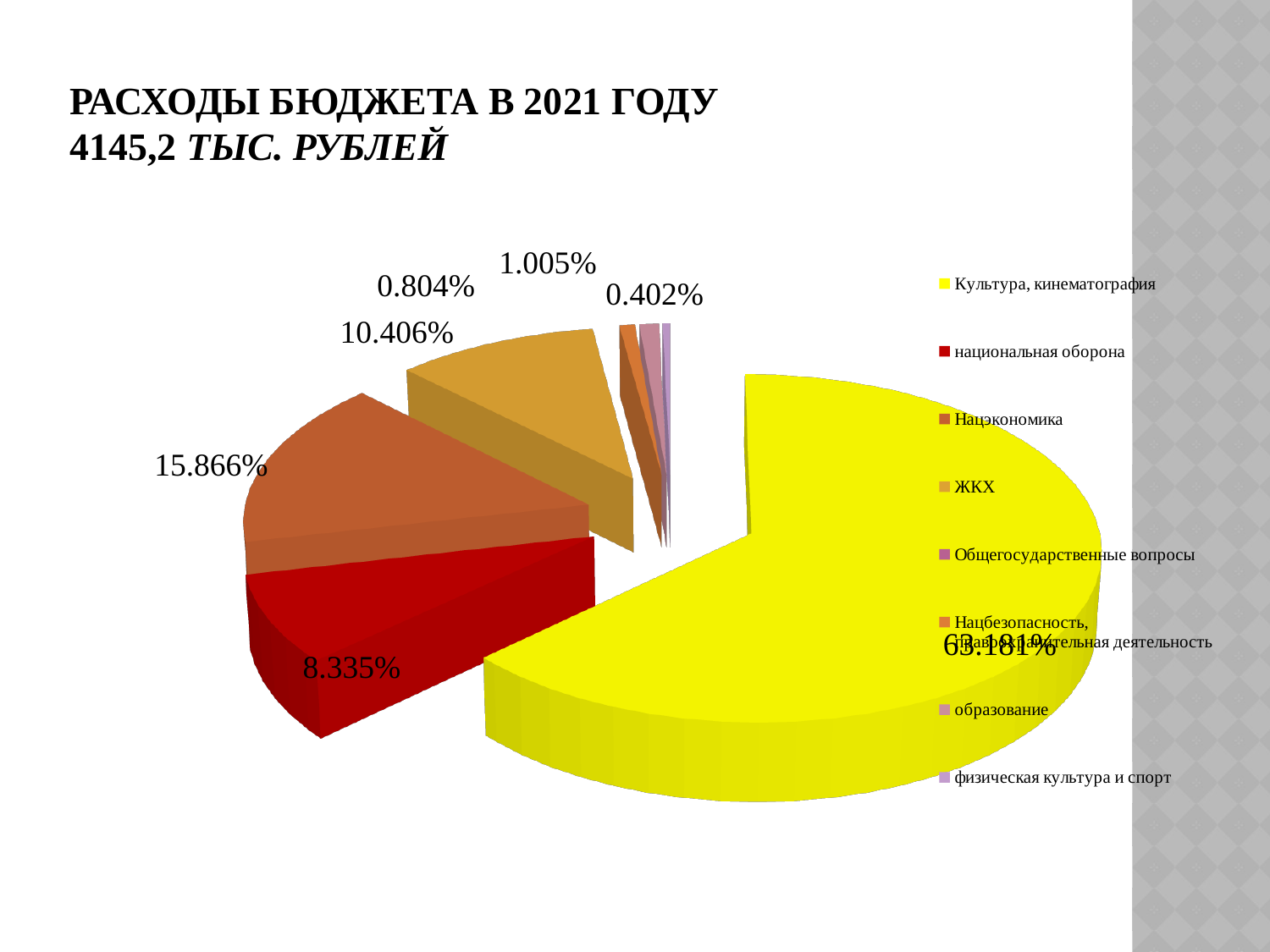
Which category has the largest share of the pie? Культура, кинематография What is the difference in percentage points between Культура, кинематография and национальная оборона? 54.846% What is the smallest percentage label shown on the pie chart? 0.402% What is the difference in percentage points between Нацэкономика and ЖКХ? 5.460% What percentage is shown for национальная оборона? 8.335% What type of chart is shown on the slide? pie chart What percentage is shown for Культура, кинематография? 63.181% How many entries does the legend list? 8 Which has the larger share, Нацэкономика or ЖКХ? Нацэкономика What percentage is shown for ЖКХ? 10.406% What is the title of the slide? РАСХОДЫ БЮДЖЕТА В 2021 ГОДУ 4145,2 ТЫС. РУБЛЕЙ What percentage is shown for Нацэкономика? 15.866%